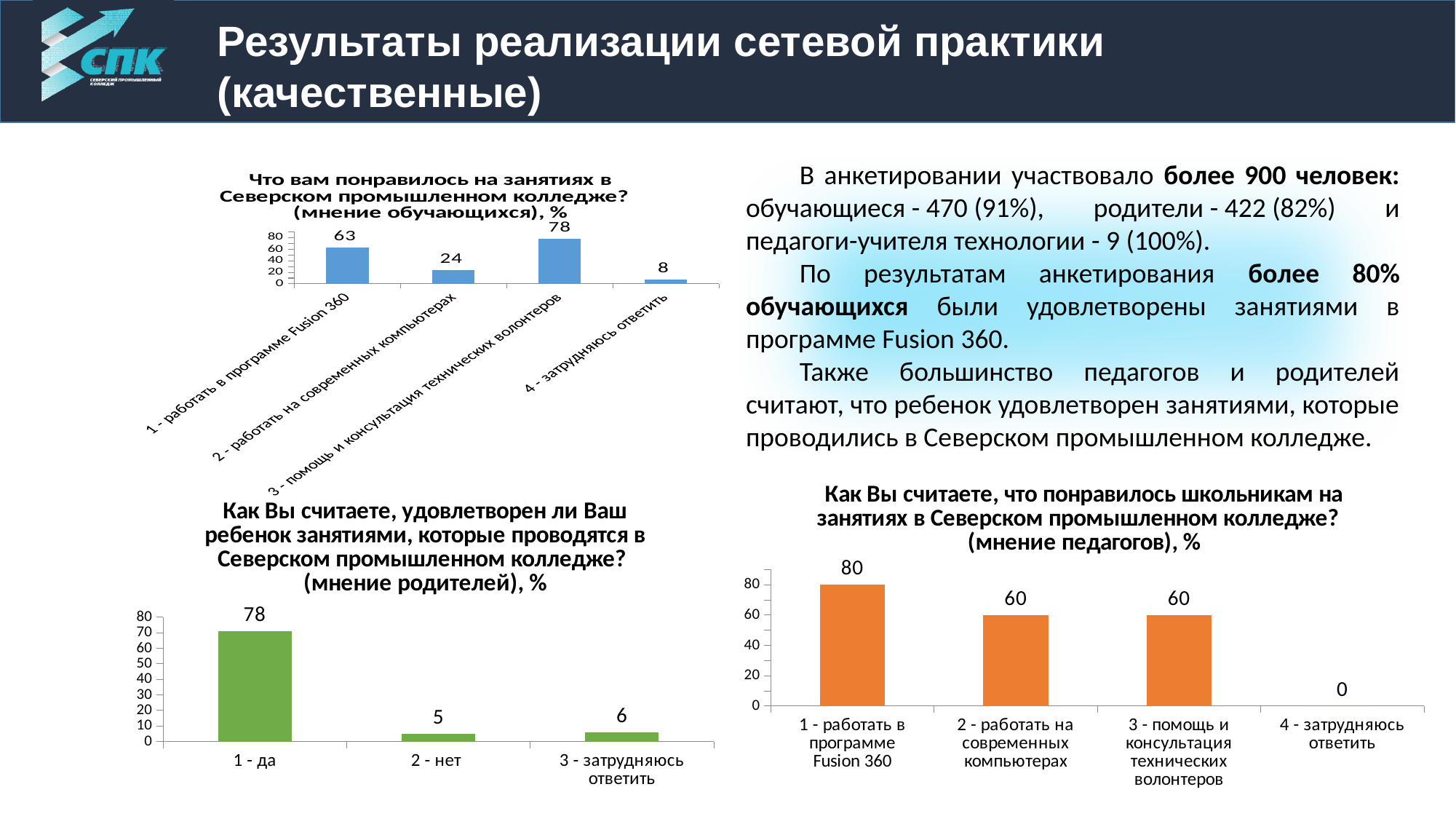
In the chart titled "Как Вы считаете, удовлетворен ли Ваш ребенок занятиями, которые проводятся в Северском промышленном колледже? (мнение родителей), %", what is the value for "1 - да"? 78 What colour are the bars in the chart titled "Как Вы считаете, что понравилось школьникам на занятиях в Северском промышленном колледже? (мнение педагогов), %"? orange In the chart titled "Что вам понравилось на занятиях в Северском промышленном колледже? (мнение обучающихся), %", what is the difference between the values for "1 - работать в программе Fusion 360" and "2 - работать на современных компьютерах"? 39 In the chart titled "Как Вы считаете, что понравилось школьникам на занятиях в Северском промышленном колледже? (мнение педагогов), %", what is the value for "4 - затрудняюсь ответить"? 0 In the chart titled "Что вам понравилось на занятиях в Северском промышленном колледже? (мнение обучающихся), %", which category has the lowest value? 4 - затрудняюсь ответить In the chart titled "Как Вы считаете, что понравилось школьникам на занятиях в Северском промышленном колледже? (мнение педагогов), %", what is the difference between the values for "1 - работать в программе Fusion 360" and "2 - работать на современных компьютерах"? 20 In the chart titled "Как Вы считаете, что понравилось школьникам на занятиях в Северском промышленном колледже? (мнение педагогов), %", which category has the highest value? 1 - работать в программе Fusion 360 What type of chart is the one titled "Как Вы считаете, удовлетворен ли Ваш ребенок занятиями, которые проводятся в Северском промышленном колледже? (мнение родителей), %"? bar chart In the chart titled "Что вам понравилось на занятиях в Северском промышленном колледже? (мнение обучающихся), %", what is the value for "3 - помощь и консультация технических волонтеров"? 78 In the chart titled "Как Вы считаете, что понравилось школьникам на занятиях в Северском промышленном колледже? (мнение педагогов), %", what is the value for "1 - работать в программе Fusion 360"? 80 In the chart titled "Как Вы считаете, удовлетворен ли Ваш ребенок занятиями, которые проводятся в Северском промышленном колледже? (мнение родителей), %", which is larger: "2 - нет" or "3 - затрудняюсь ответить"? 3 - затрудняюсь ответить How many categories are shown in the chart titled "Что вам понравилось на занятиях в Северском промышленном колледже? (мнение обучающихся), %"? 4